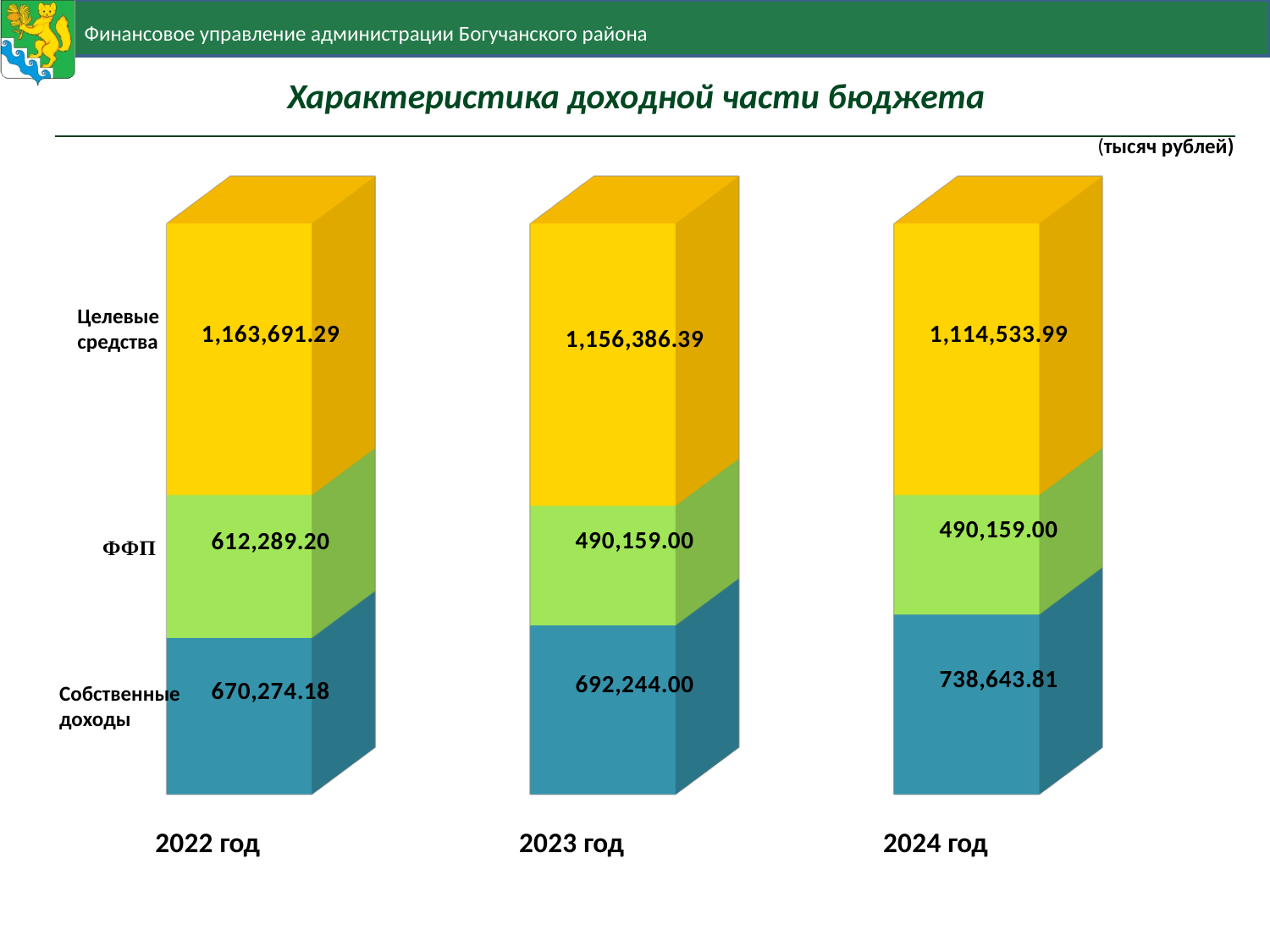
What is the value of Собственные доходы for 2024 год? 738,643.81 What is the total of the stacked bar for 2023 год? 2,338,789.39 Which is larger: Собственные доходы in 2023 год or ФФП in 2022 год? Собственные доходы in 2023 год What is the difference between ФФП in 2022 год and in 2023 год? 122,130.20 What is the difference between Собственные доходы in 2024 год and in 2022 год? 68,369.63 Do the values for Собственные доходы rise or fall from 2022 год to 2024 год? Rise What kind of chart is shown on the slide? Stacked bar chart Which year has the highest value for Собственные доходы? 2024 год What is the value of ФФП for 2023 год? 490,159.00 Which year has the lowest value for Целевые средства? 2024 год What is the value of Целевые средства for 2022 год? 1,163,691.29 How many years are shown on the chart? 3